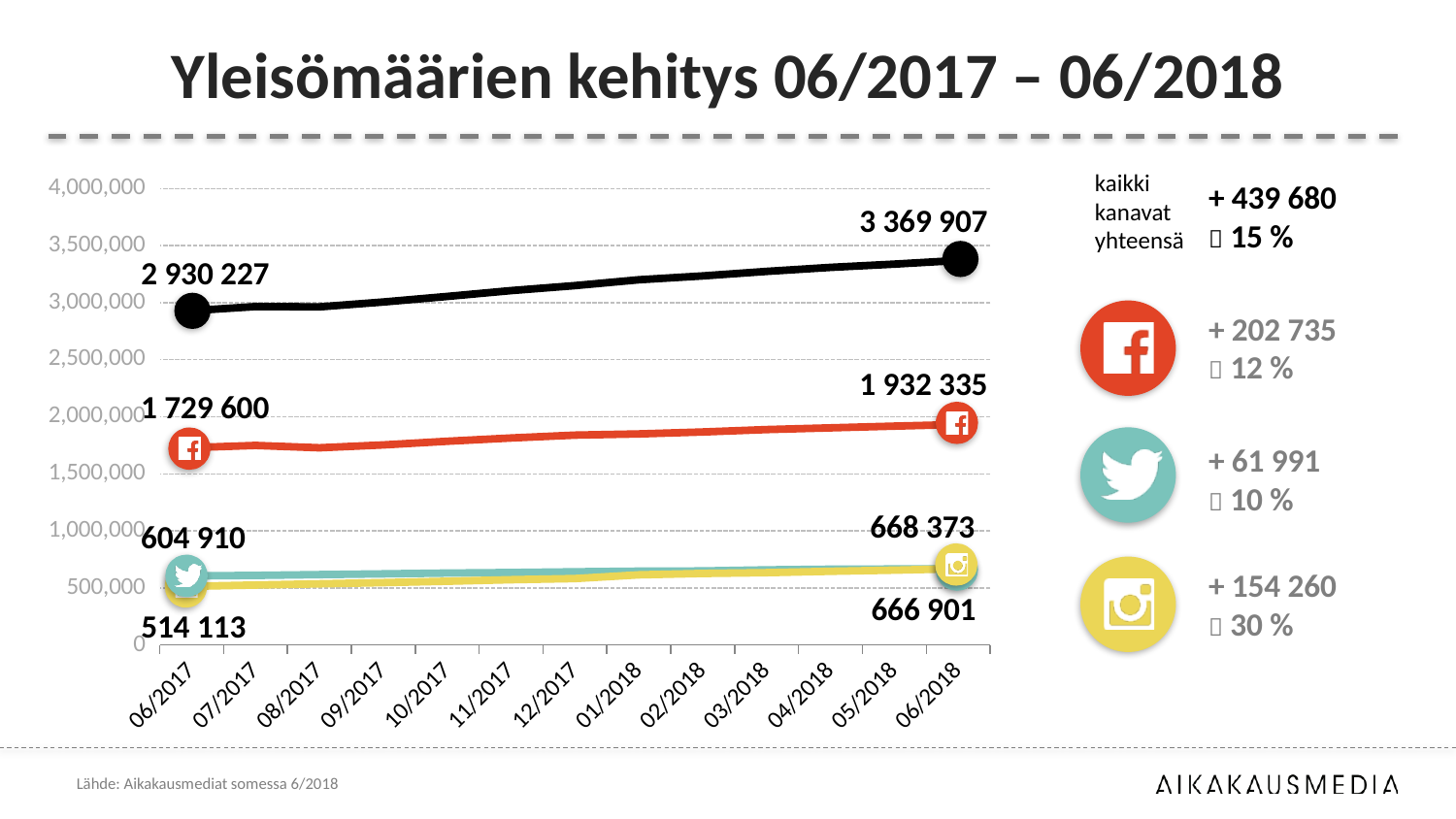
By how much did the Facebook (red) line increase from 06/2017 to 06/2018? 202 735 By how much did the black (total) line increase from 06/2017 to 06/2018? 439 680 What is the value of the black (total) line at 06/2017? 2 930 227 What is the value of the Facebook (red) line at 06/2018? 1 932 335 What is the value of the Facebook (red) line at 06/2017? 1 729 600 What is the value of the black (total) line at 06/2018? 3 369 907 What is the value of the Twitter (teal) line at 06/2017? 604 910 Does the black (total) line rise or fall from 06/2017 to 06/2018? Rise How many months are shown on the x axis? 13 Is the value of the Facebook (red) line at 06/2018 greater or less than 2,000,000? less What is the title of the chart? Yleisömäärien kehitys 06/2017 – 06/2018 What type of chart is shown on the slide? Line chart